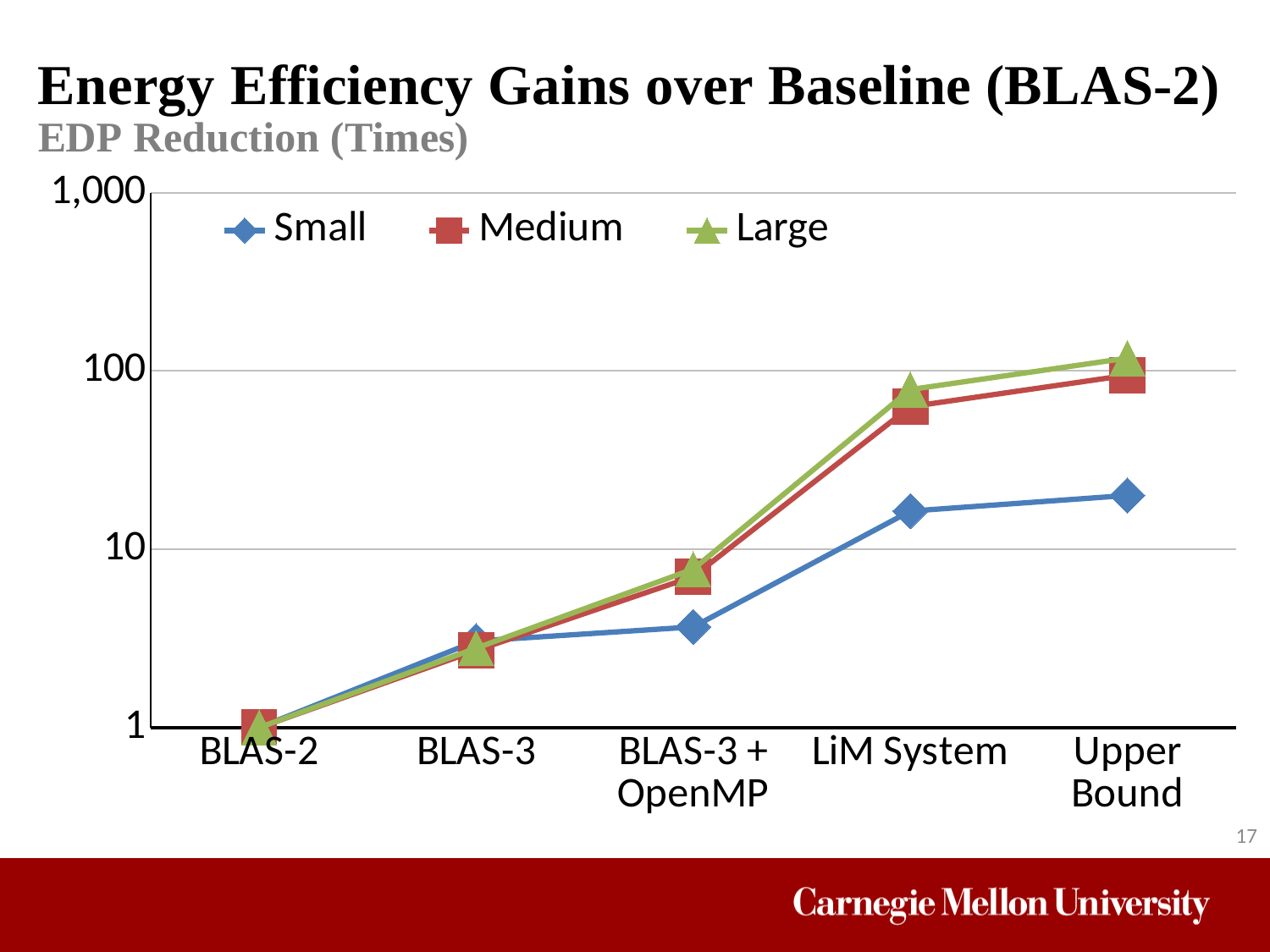
How many categories are shown along the x axis? 5 What kind of chart is shown on the slide? line chart Do the values for the Medium series rise or fall from BLAS-2 to Upper Bound? rise Is the value for the Small series at LiM System greater or less than 10? greater For the Small series, which category has the highest value? Upper Bound What is the value for the Small series at BLAS-2? 1 How many series does the legend list? 3 Is the value for the Small series at BLAS-3 + OpenMP greater or less than 10? less At Upper Bound, which series has the larger value, Small or Large? Large What is the label shown above the y axis of the chart? EDP Reduction (Times) Is the value for the Large series at Upper Bound greater or less than 100? greater